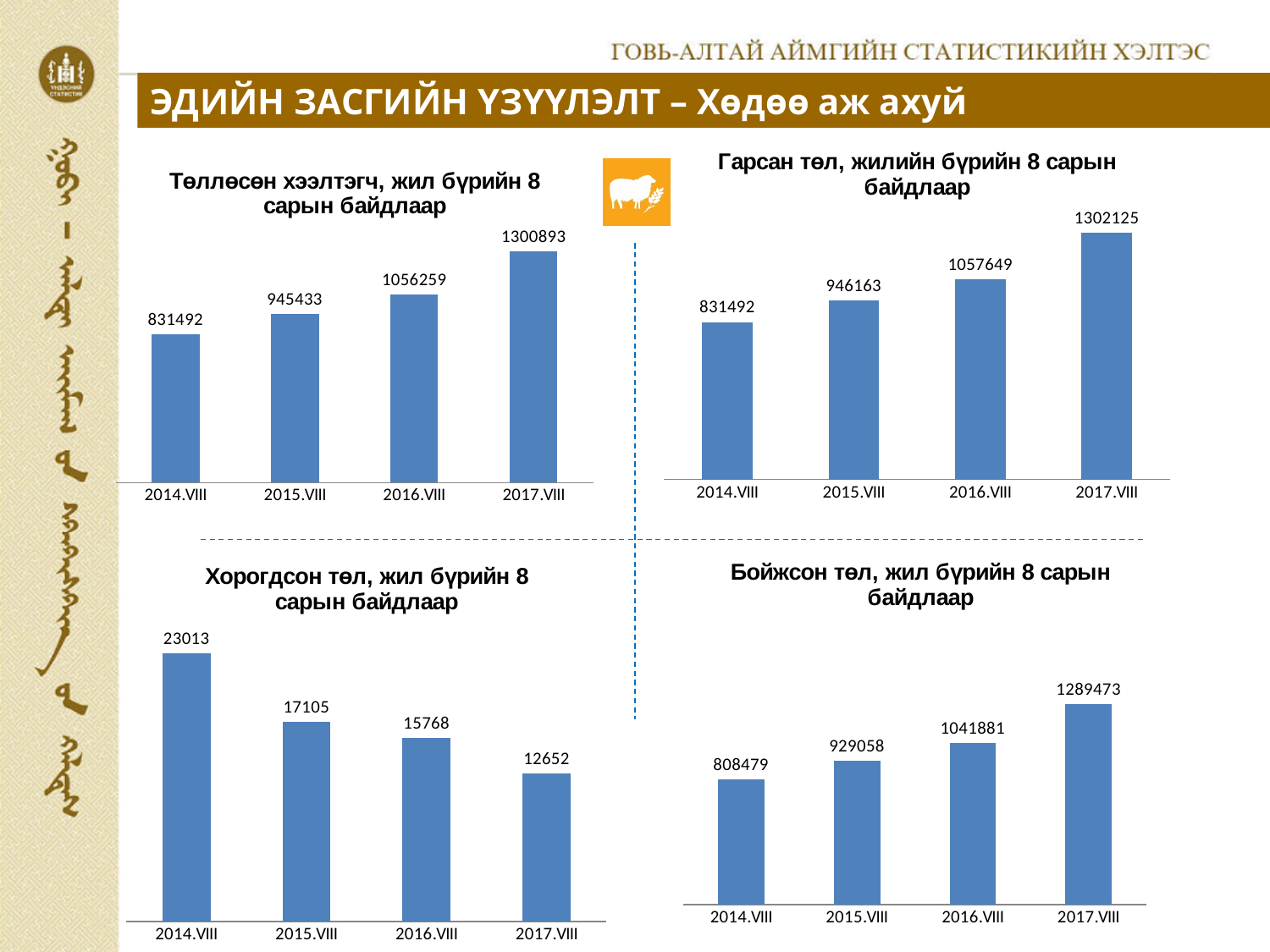
In the bottom-left chart (Хорогдсон төл), what is the difference between the values for 2014.VIII and 2017.VIII? 10361 In the top-left chart (Төллөсөн хээлтэгч), which is larger: the value for 2015.VIII or 2016.VIII? 2016.VIII In the bottom-right chart (Бойжсон төл), what is the value for 2014.VIII? 808479 In the bottom-left chart (Хорогдсон төл), what is the value for 2015.VIII? 17105 In the top-right chart (Гарсан төл), what is the value for 2016.VIII? 1057649 How many categories are shown in the top-right chart (Гарсан төл)? 4 What kind of chart is the bottom-left chart (Хорогдсон төл)? Bar chart In the bottom-right chart (Бойжсон төл), what is the difference between the values for 2017.VIII and 2016.VIII? 247592 In the top-left chart (Төллөсөн хээлтэгч), what is the value for 2017.VIII? 1300893 In the top-right chart (Гарсан төл), which category has the lowest value? 2014.VIII In the bottom-left chart (Хорогдсон төл), do the values rise or fall from 2014.VIII to 2017.VIII? Fall In the bottom-left chart (Хорогдсон төл), which category has the highest value? 2014.VIII